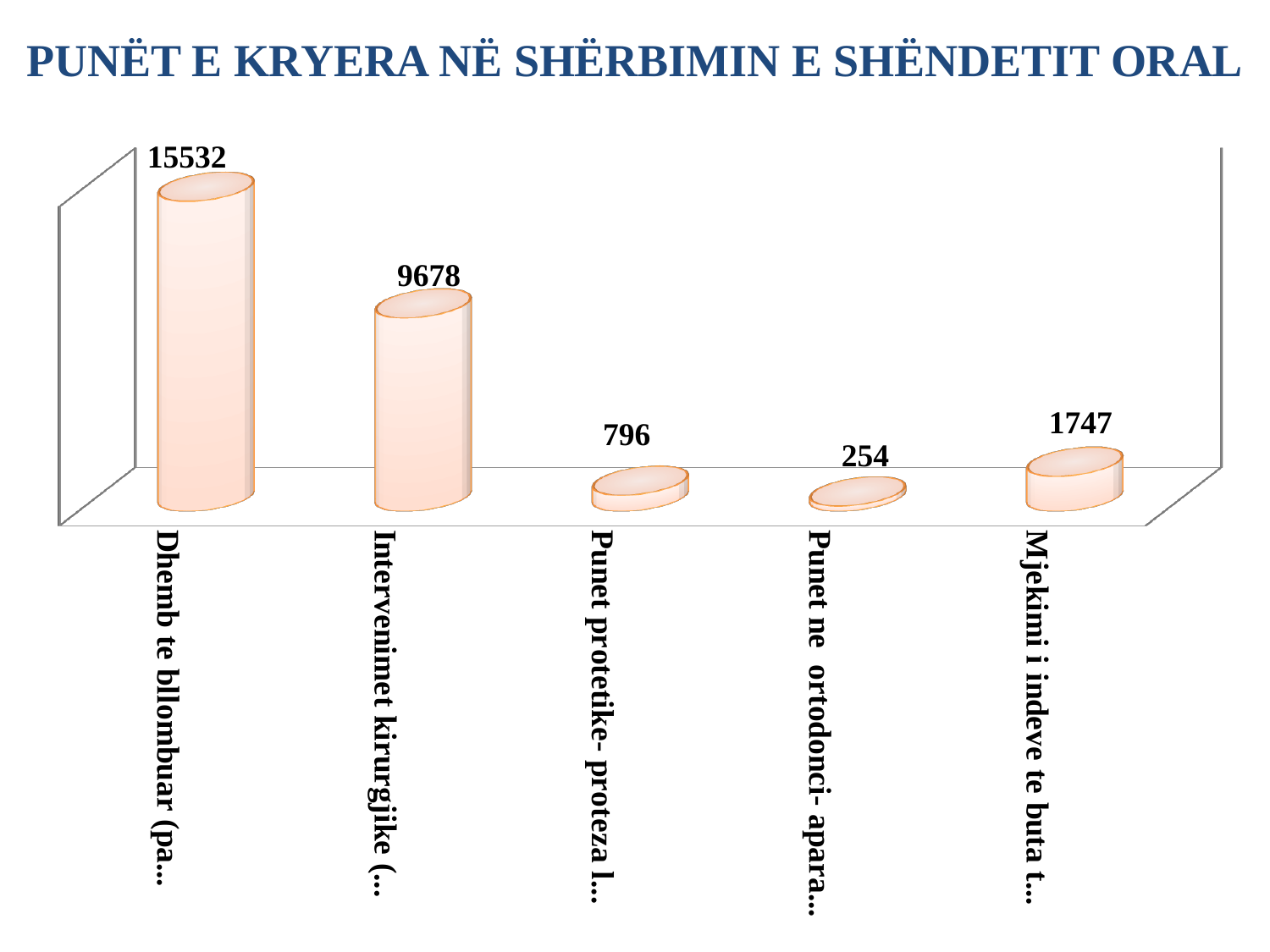
Which is larger, the value for "Mjekimi i indeve te buta" or the value for "Punet protetike- proteza"? Mjekimi i indeve te buta What value is shown for the category "Punet ne ortodonci- apara..."? 254 How many categories are shown in the chart? 5 Which category has the lowest value? Punet ne ortodonci- apara... What is the difference between the values for "Dhemb te bllombuar" and "Intervenimet kirurgjike"? 5854 What value is shown for the category "Dhemb te bllombuar"? 15532 What is the title of the slide? PUNËT E KRYERA NË SHËRBIMIN E SHËNDETIT ORAL What kind of chart is shown on the slide? Bar chart What value is shown for the category "Punet protetike- proteza"? 796 What value is shown for the category "Intervenimet kirurgjike"? 9678 What value is shown for the category "Mjekimi i indeve te buta"? 1747 Which category has the highest value? Dhemb te bllombuar